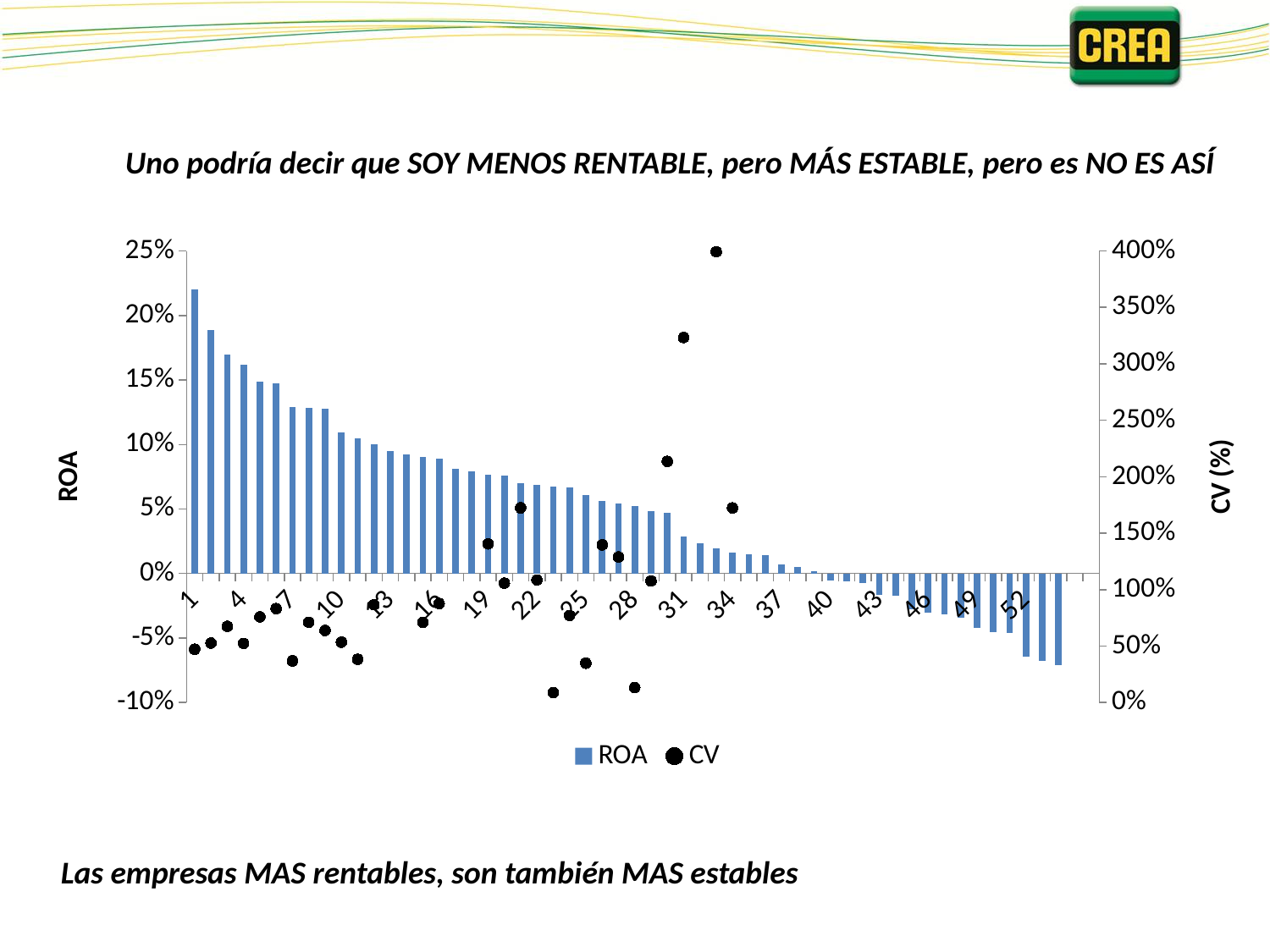
Is the ROA value for category 31 greater or less than 5%? less What kind of chart is shown on the slide? A combination chart of bars (ROA) and scatter points (CV) How many series does the legend list? 2 Do the ROA bars rise or fall as you move from left to right along the x axis? Fall Which has the larger ROA, category 4 or category 10? Category 4 Which category has the highest ROA? 1 What are the two series named in the legend? ROA and CV What is the title of the right-hand vertical axis? CV (%) Is the ROA value for category 7 greater or less than 15%? less Is the ROA value for category 52 greater or less than -5%? less